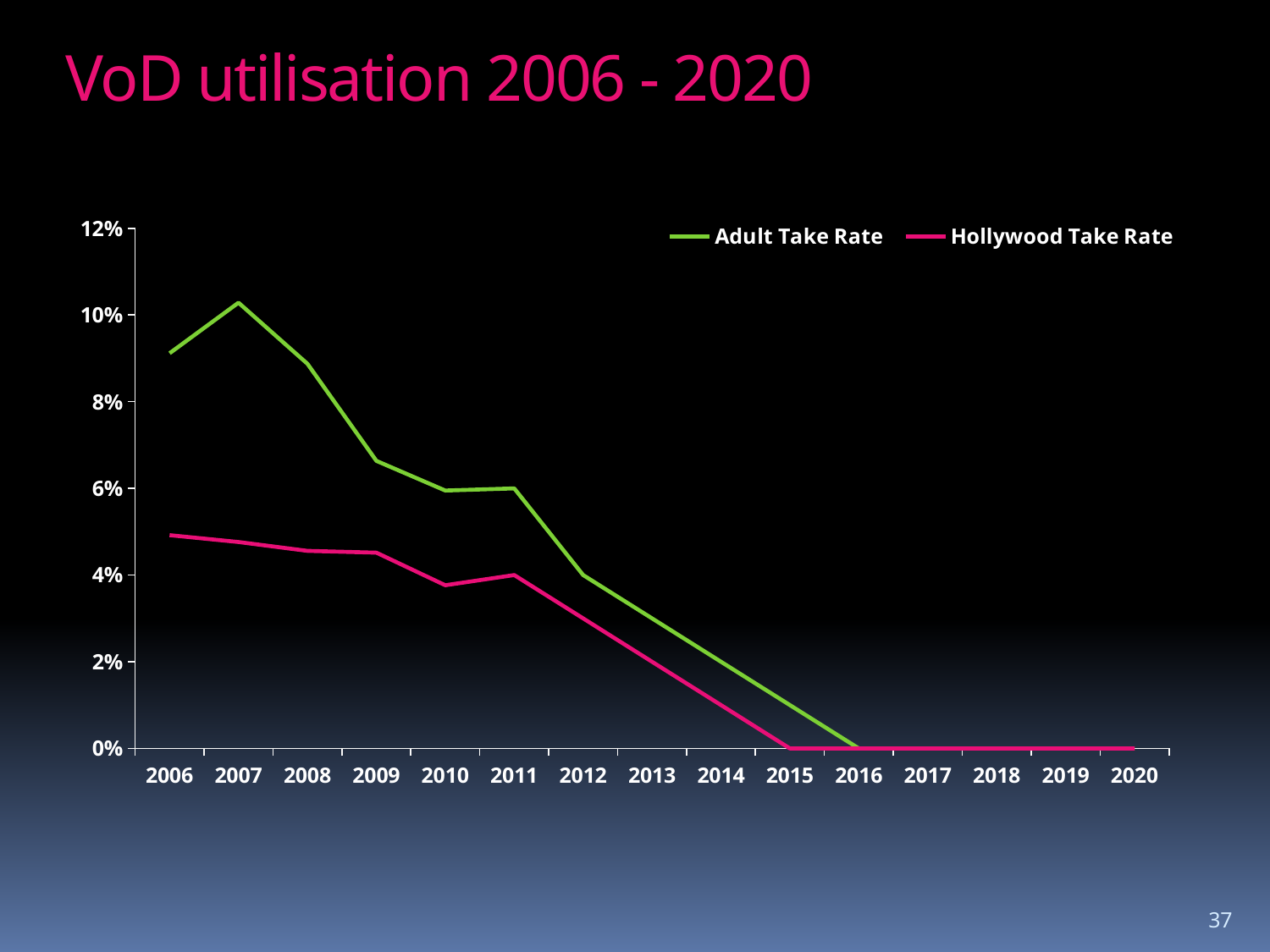
What is the Hollywood Take Rate in 2018? 0% Is the Adult Take Rate in 2009 greater or less than 6%? greater Is the Adult Take Rate in 2006 greater or less than 8%? greater In which year is the Hollywood Take Rate highest? 2006 In which year is the Adult Take Rate highest? 2007 What kind of chart is shown on the slide? Line chart Which series has the larger value in 2006, Adult Take Rate or Hollywood Take Rate? Adult Take Rate Do the Adult Take Rate values generally rise or fall from 2007 to 2016? Fall What is the title of the chart? VoD utilisation 2006 - 2020 How many years are shown on the x axis? 15 Is the Hollywood Take Rate in 2010 greater or less than 4%? less How many series does the legend list? 2